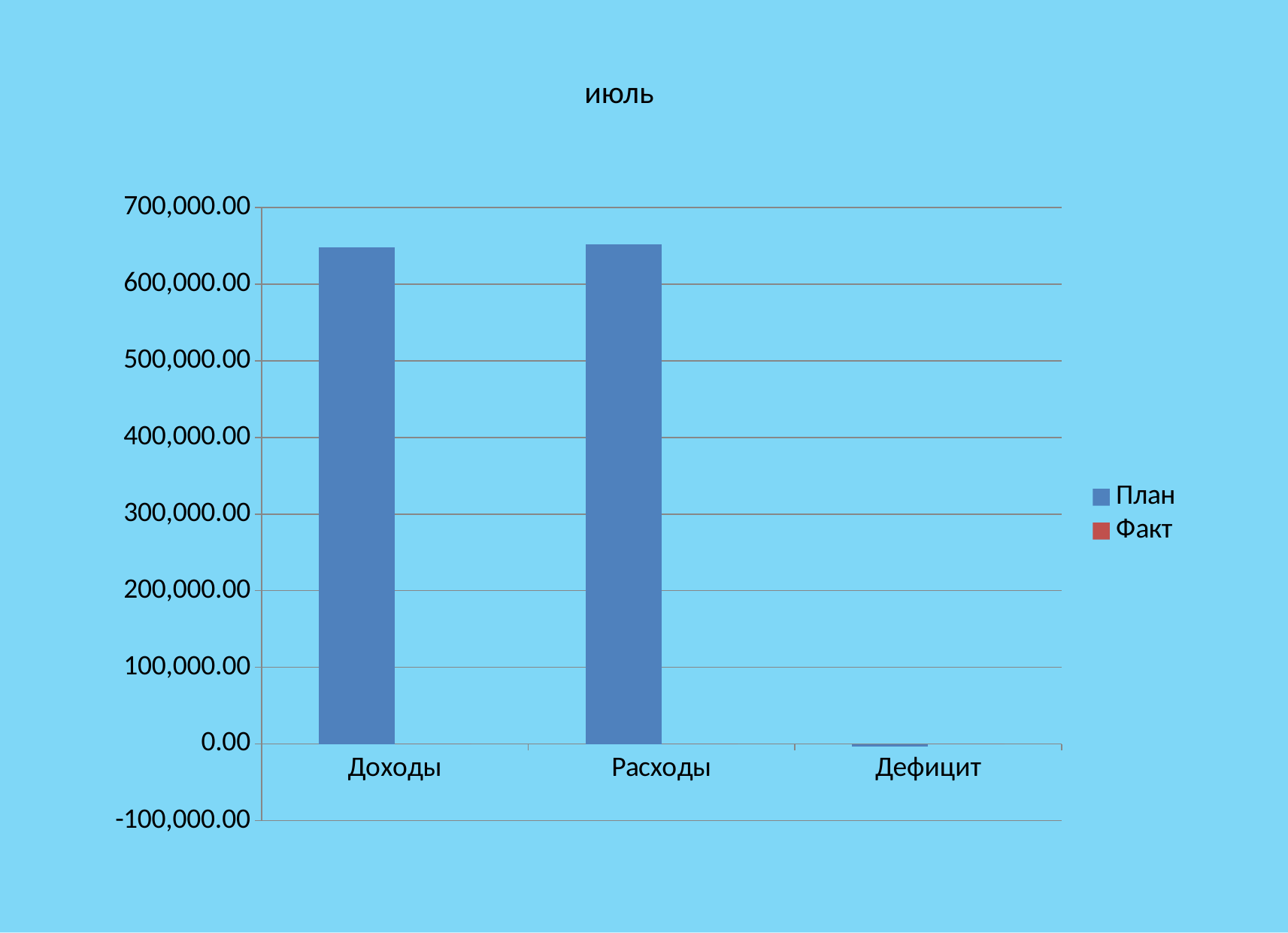
What are the two series named in the legend? План and Факт Which is larger, the План value for Доходы or for Дефицит? Доходы Which category has the lowest План value? Дефицит How many series does the legend list? 2 Which is larger, the План value for Расходы or for Дефицит? Расходы How many categories are shown on the x axis? 3 Is the План value for Доходы greater or less than 600,000.00? greater What is the title of the chart? июль Is the План value for Дефицит greater or less than 100,000.00? less Is the План value for Расходы greater or less than 700,000.00? less What kind of chart is shown on the slide? bar chart